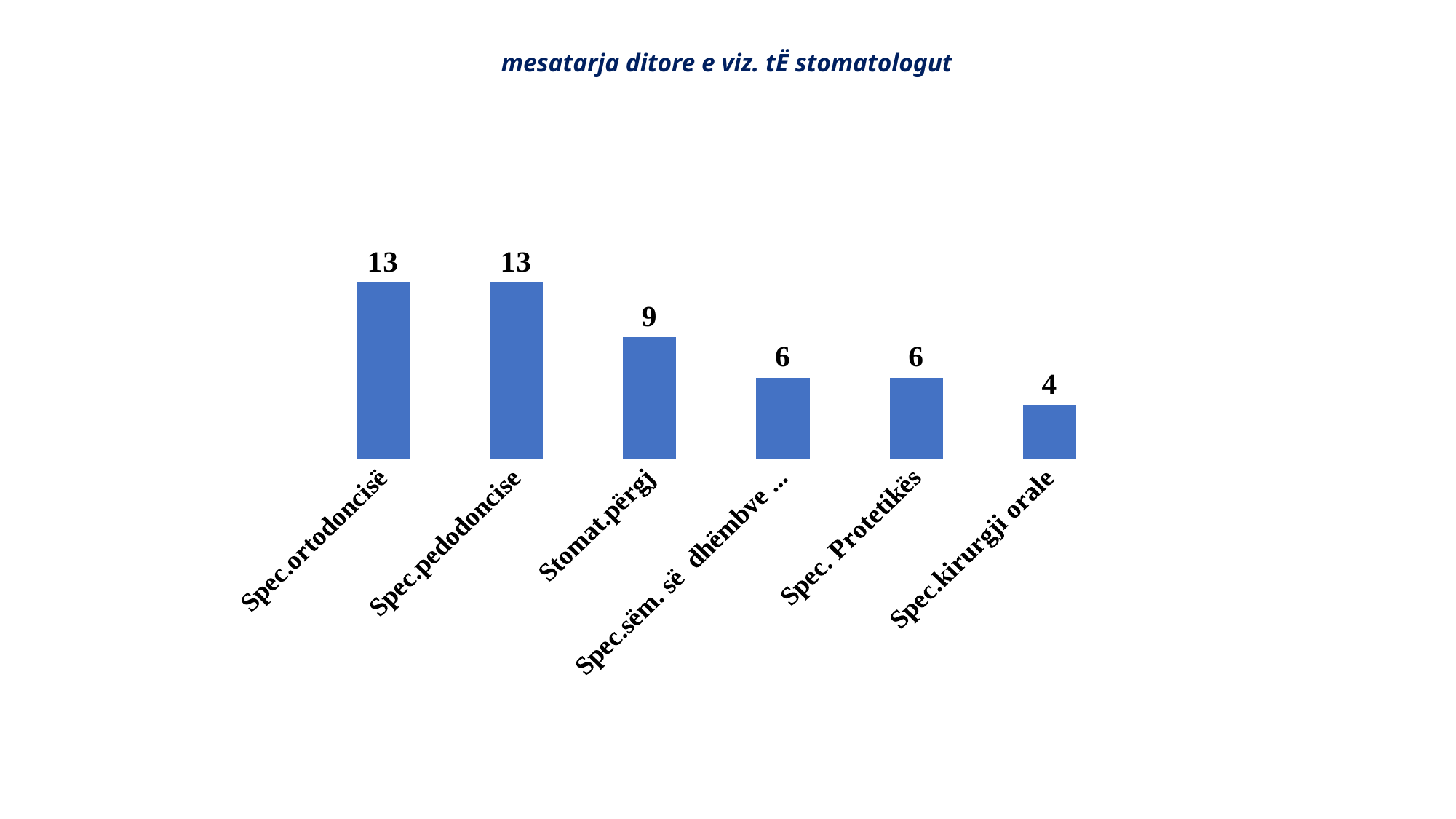
What is the difference between the values for Spec.pedodoncise and Spec.kirurgji orale? 9 What is the difference between the values for Stomat.përgj and Spec. Protetikës? 3 What is the value for Spec.ortodoncisë? 13 What is the value for Spec.kirurgji orale? 4 What is the value for Spec. Protetikës? 6 What is the title of the chart? mesatarja ditore e viz. tË stomatologut How many categories are shown in the chart? 6 Which is larger, the value for Stomat.përgj or the value for Spec. Protetikës? Stomat.përgj Which category has the lowest value? Spec.kirurgji orale What is the value for Stomat.përgj? 9 Do the values rise or fall from left to right along the x axis? Fall What kind of chart is shown on the slide? Bar chart